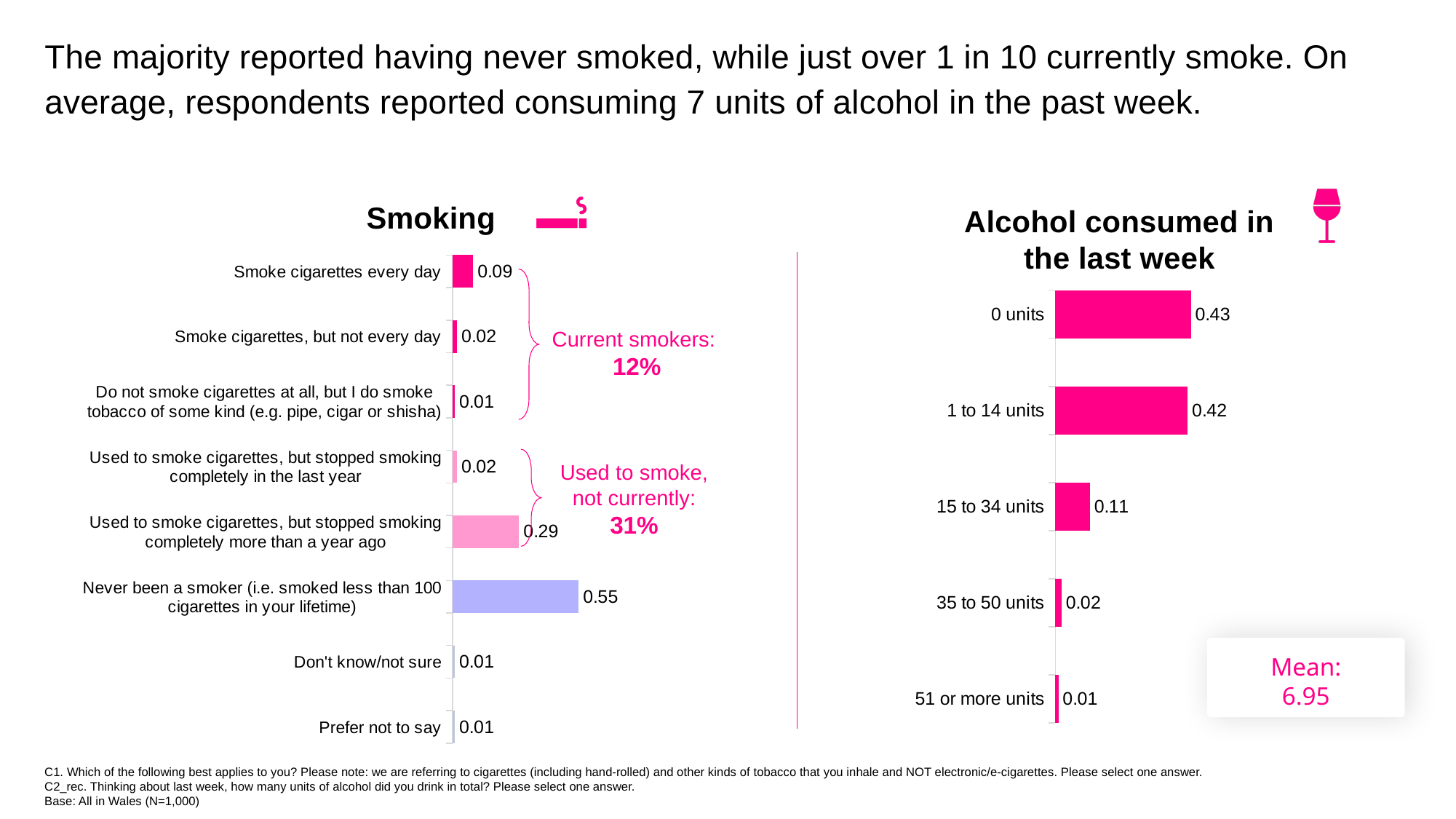
In the 'Alcohol consumed in the last week' chart, which is larger: '15 to 34 units' or '35 to 50 units'? 15 to 34 units In the Smoking chart, what percentage is given for current smokers? 12% In the Smoking chart, how many categories are shown? 8 In the Smoking chart, what is the value for 'Never been a smoker (i.e. smoked less than 100 cigarettes in your lifetime)'? 0.55 In the 'Alcohol consumed in the last week' chart, how many categories are shown? 5 In the Smoking chart, what is the value for 'Smoke cigarettes every day'? 0.09 In the Smoking chart, which category has the highest value? Never been a smoker (i.e. smoked less than 100 cigarettes in your lifetime) In the 'Alcohol consumed in the last week' chart, which category has the lowest value? 51 or more units What kind of chart is the 'Alcohol consumed in the last week' chart? Bar chart In the 'Alcohol consumed in the last week' chart, what is the value for '15 to 34 units'? 0.11 In the Smoking chart, what is the difference between 'Never been a smoker' and 'Used to smoke cigarettes, but stopped smoking completely more than a year ago'? 0.26 In the 'Alcohol consumed in the last week' chart, what is the value for '1 to 14 units'? 0.42